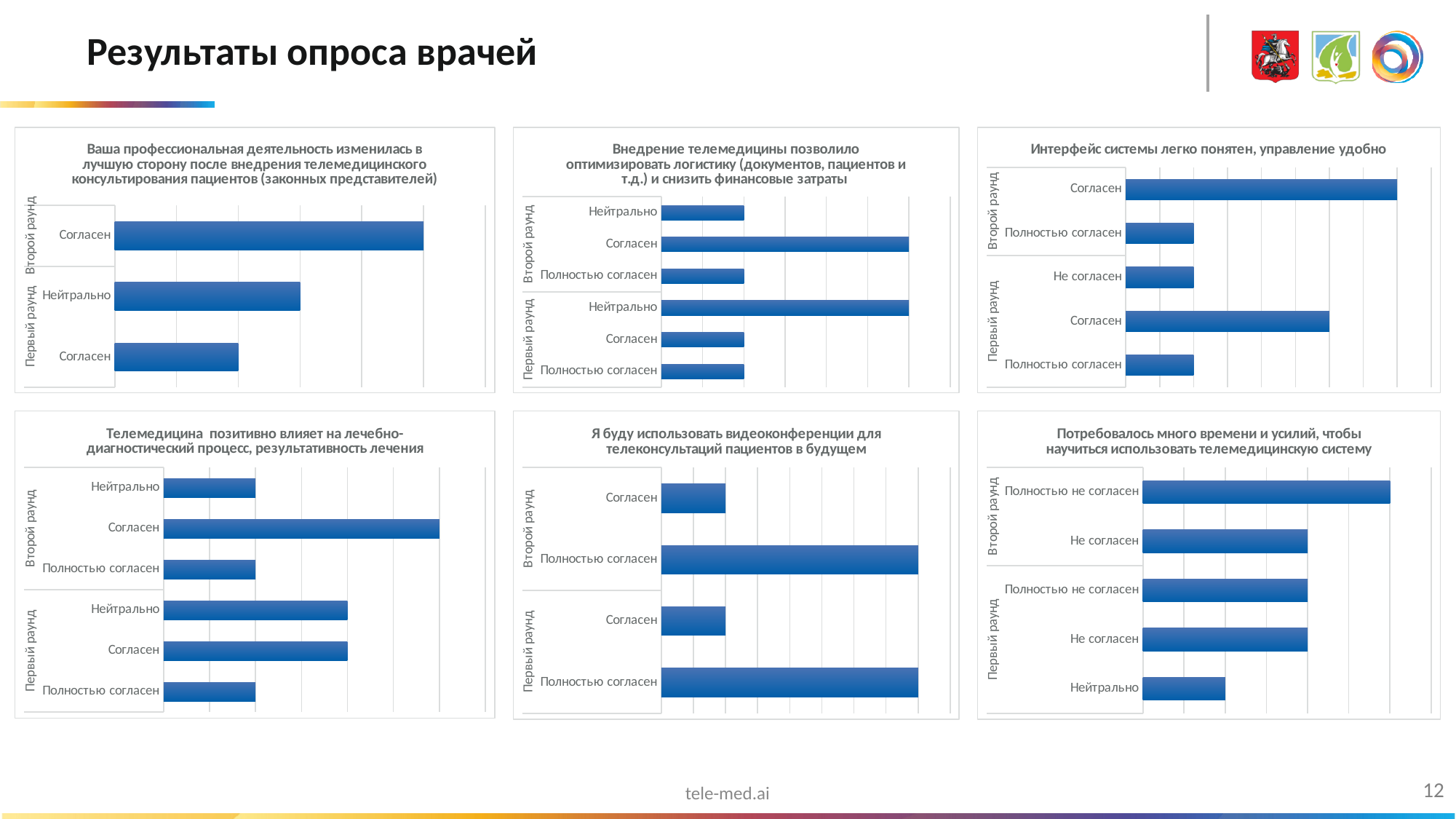
In the top-right chart ("Интерфейс системы легко понятен, управление удобно"), which category has the longest bar? Согласен (Второй раунд) In the top-left chart ("Ваша профессиональная деятельность изменилась в лучшую сторону..."), how many bars are plotted? 3 In the top-right chart ("Интерфейс системы легко понятен, управление удобно"), is the bar for Согласен larger in Второй раунд or in Первый раунд? Второй раунд How many charts are shown on the slide? 6 In the bottom-middle chart ("Я буду использовать видеоконференции для телеконсультаций пациентов в будущем"), which is larger in Второй раунд: Согласен or Полностью согласен? Полностью согласен In the top-middle chart ("Внедрение телемедицины позволило оптимизировать логистику..."), how many bars are plotted? 6 In the top-left chart ("Ваша профессиональная деятельность изменилась в лучшую сторону..."), which category has the longest bar? Согласен (Второй раунд) In the bottom-right chart ("Потребовалось много времени и усилий..."), which category has the longest bar? Полностью не согласен (Второй раунд) In the top-left chart ("Ваша профессиональная деятельность изменилась в лучшую сторону..."), which category has the shortest bar? Согласен (Первый раунд) In the bottom-right chart ("Потребовалось много времени и усилий, чтобы научиться использовать телемедицинскую систему"), which category has the shortest bar? Нейтрально (Первый раунд) What kind of chart is used in the top-left chart titled "Ваша профессиональная деятельность изменилась в лучшую сторону..."? Bar chart